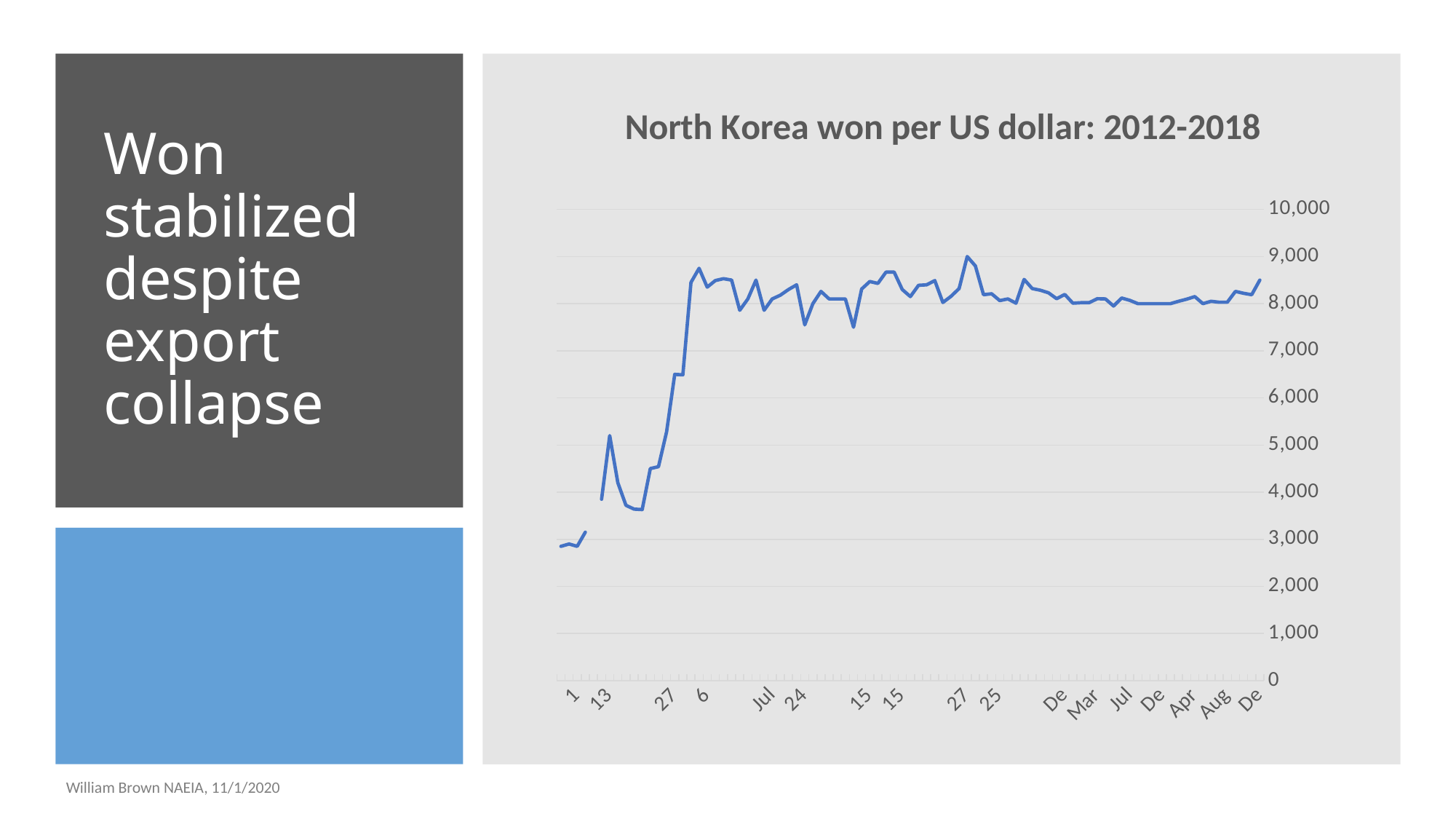
What kind of chart is shown on the slide? line chart Does the line rise or fall between the x-axis labels "1" and "6"? rise What is the highest value shown on the vertical axis of the chart? 10,000 What is the title of the chart? North Korea won per US dollar: 2012-2018 Is the value at the first x-axis label "1" greater or less than 4,000? less Overall, does the won per US dollar rise or fall from the start of the series to the end? rise Is the highest point on the line greater or less than 8,000? greater Is the value at the final x-axis label "De" greater or less than 7,000? greater Which is larger: the value at the x-axis label "1" or the value at the final x-axis label "De"? De Which is larger: the value at the first x-axis label "27" or the value at the x-axis label "6"? 6